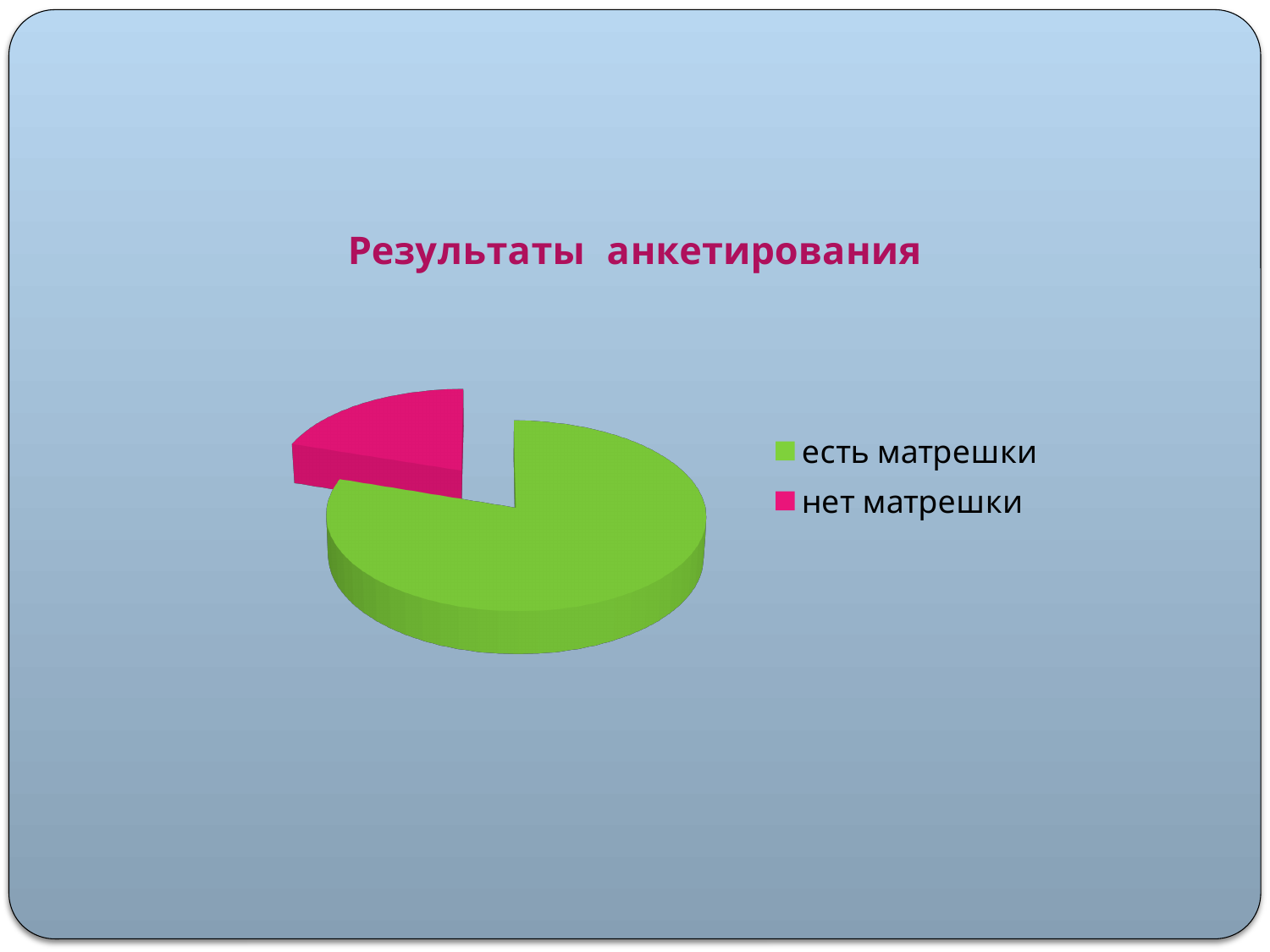
How many entries does the legend list? 2 Which category has the largest slice of the pie? есть матрешки Which category has the smallest slice of the pie? нет матрешки How many slices does the pie chart have? 2 What colour is the slice for "нет матрешки"? pink What kind of chart is shown on the slide? pie chart What is the title of the chart? Результаты анкетирования Which slice is larger, "есть матрешки" or "нет матрешки"? есть матрешки